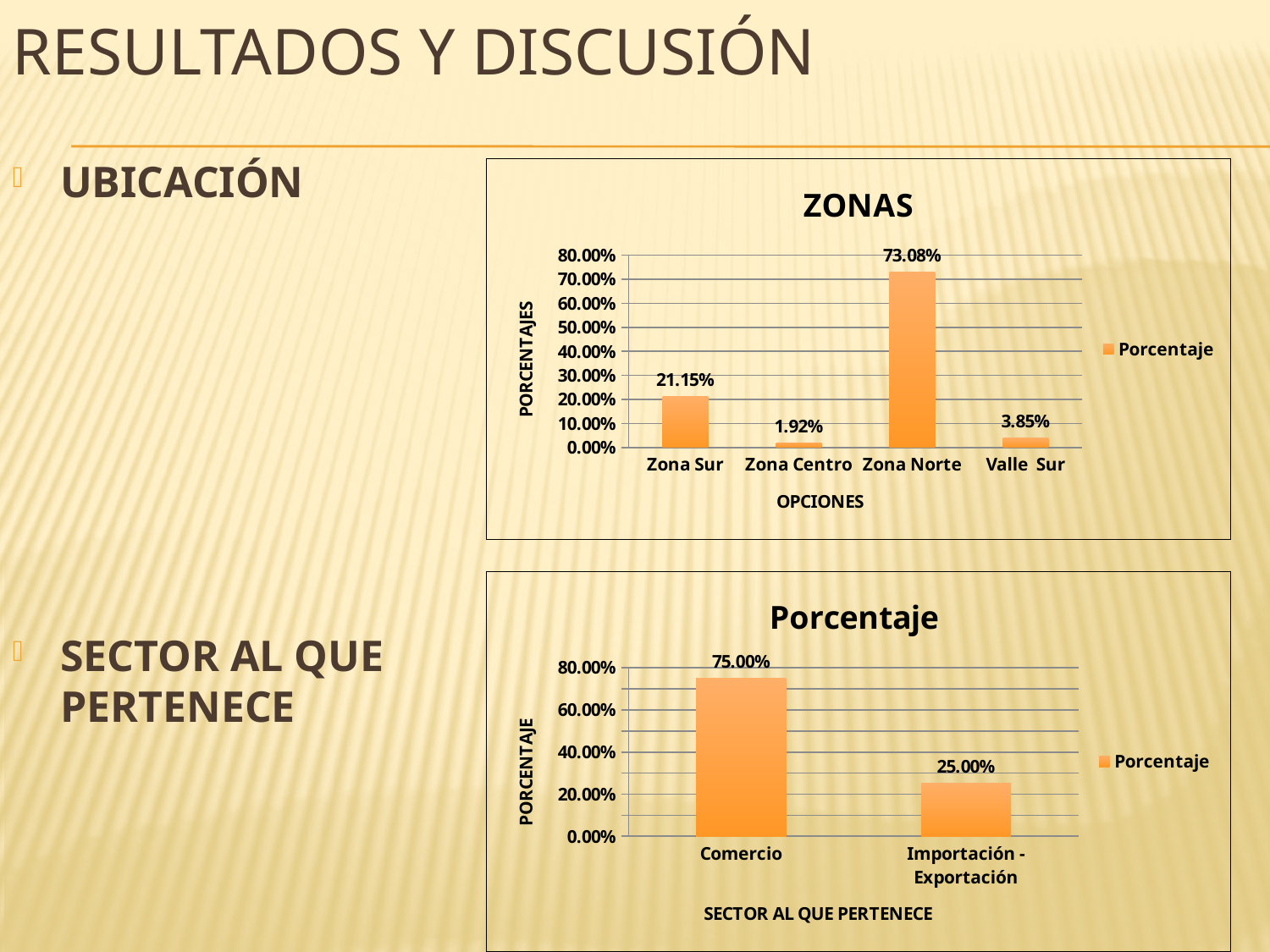
In the ZONAS chart, what is the difference between Zona Norte and Zona Sur? 51.93% In the Porcentaje chart at the bottom, what is the value for Comercio? 75.00% In the Porcentaje chart at the bottom, what is the difference between Comercio and Importación - Exportación? 50.00% In the ZONAS chart, which zone has the highest percentage? Zona Norte What kind of chart is the Porcentaje chart at the bottom of the slide? Bar chart What is the x-axis title of the ZONAS chart? OPCIONES In the ZONAS chart, which is larger, Valle Sur or Zona Centro? Valle Sur In the ZONAS chart, what is the value for Zona Sur? 21.15% In the ZONAS chart, what is the value for Zona Norte? 73.08% In the ZONAS chart, which zone has the lowest percentage? Zona Centro In the Porcentaje chart at the bottom, what is the value for Importación - Exportación? 25.00% How many categories are shown in the ZONAS chart? 4